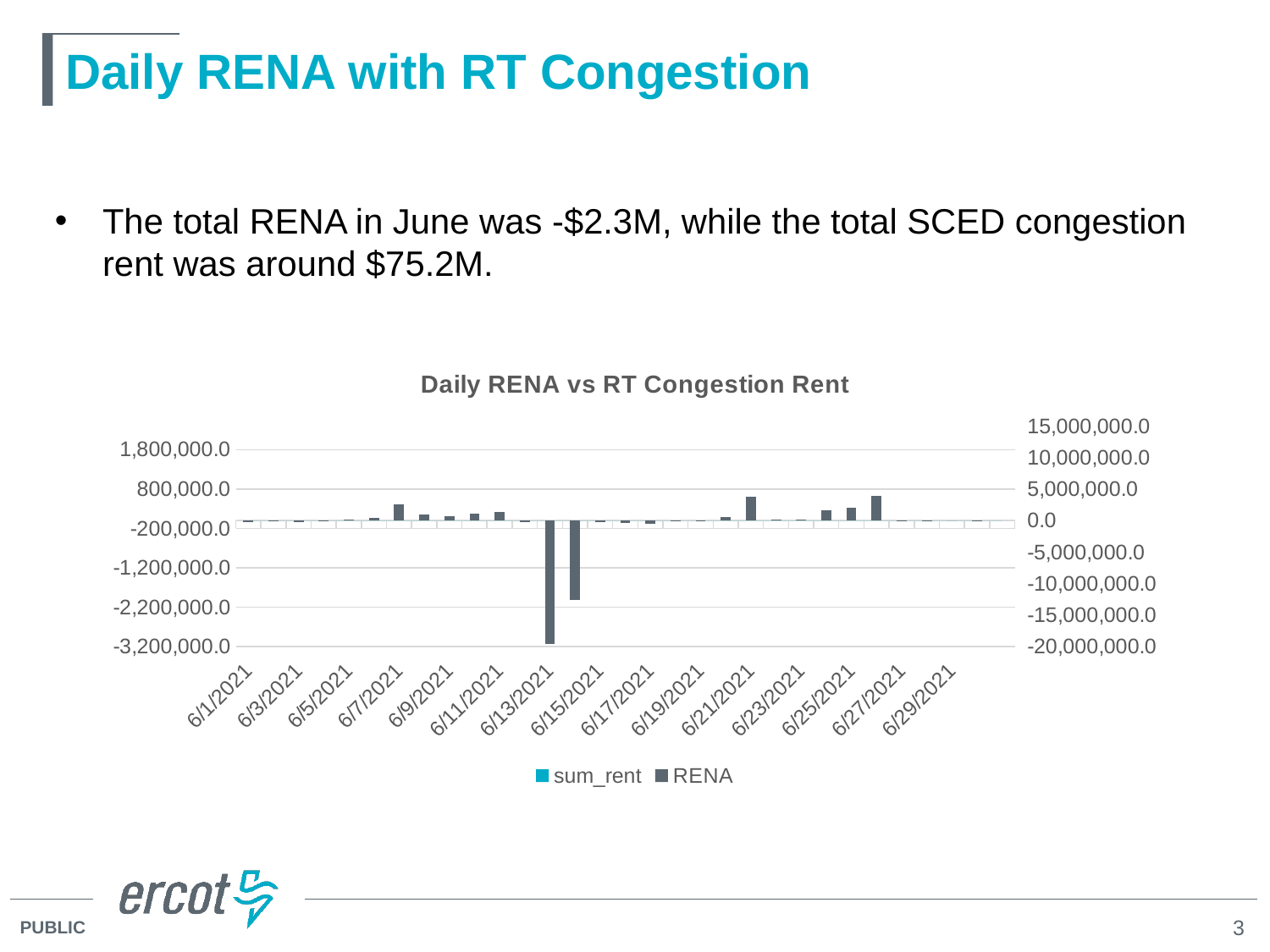
How many series does the chart legend list? 2 Is the RENA value for 6/26/2021 greater or less than 0.0? greater Is the RENA value for 6/14/2021 greater or less than -1,200,000.0 on the left axis? less Is the RENA value for 6/13/2021 greater or less than -2,200,000.0 on the left axis? less Which is larger, the RENA value on 6/13/2021 or on 6/14/2021? 6/14/2021 What is the title of the chart? Daily RENA vs RT Congestion Rent On which date does the RENA series reach its lowest value? 6/13/2021 Which series is shown in teal in the chart legend? sum_rent What kind of chart is shown on the slide? bar chart